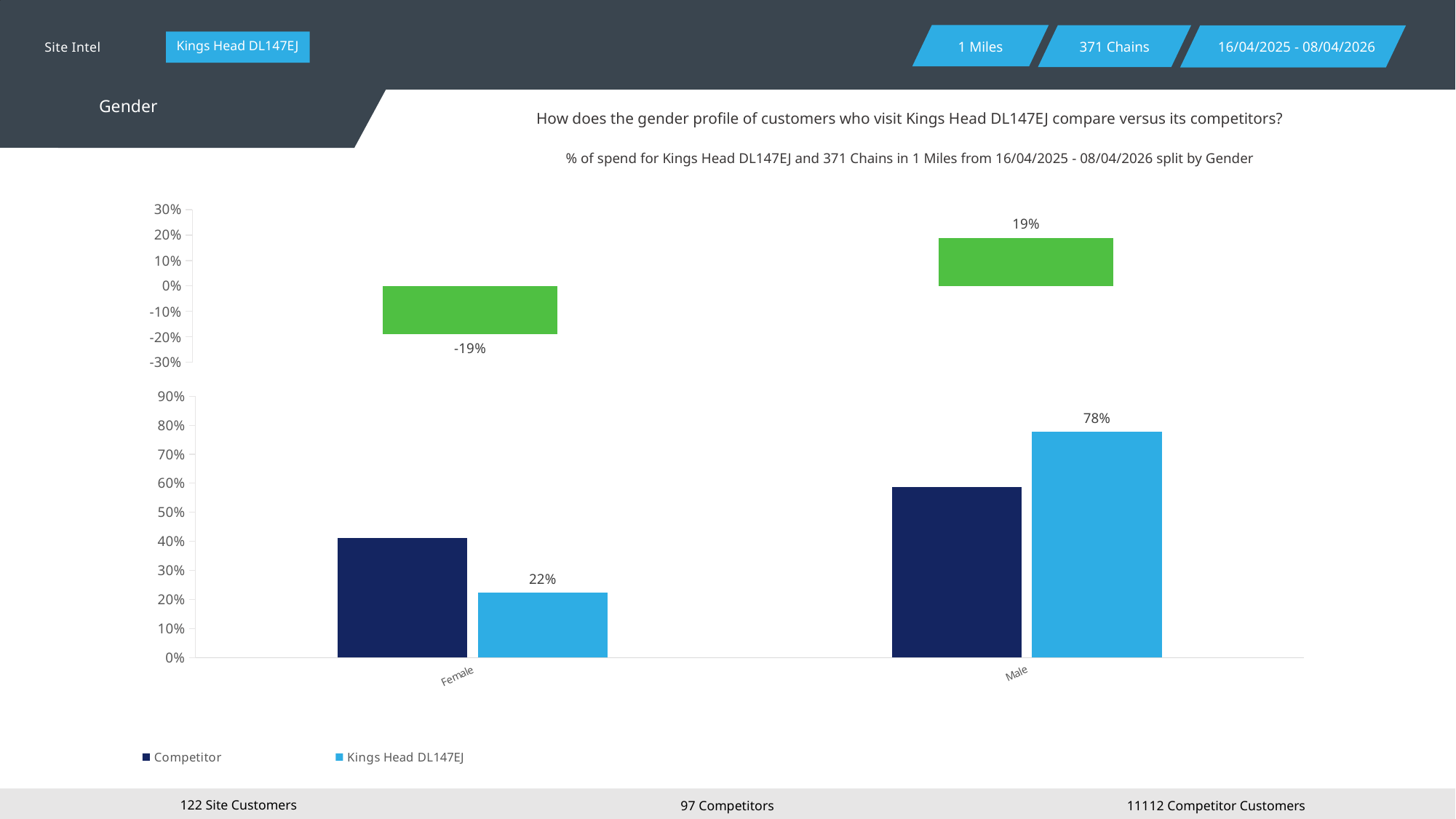
How many categories are shown on the x axis of the bottom chart? 2 In the bottom chart, which is larger for Female: Competitor or Kings Head DL147EJ? Competitor In the bottom chart, what is the value for Kings Head DL147EJ for Male? 78% In the top chart, what is the value shown for Female? -19% In the bottom chart, what is the difference between the Kings Head DL147EJ values for Male and Female? 56% In the bottom chart, is the Competitor value for Male greater or less than 50%? greater In the top chart, what is the value shown for Male? 19% In the bottom chart, which is larger for Male: Competitor or Kings Head DL147EJ? Kings Head DL147EJ In the bottom chart, is the Competitor value for Female greater or less than 50%? less In the bottom chart, what is the value for Kings Head DL147EJ for Female? 22% How many series does the legend of the bottom chart list? 2 What kind of chart is the bottom chart? bar chart